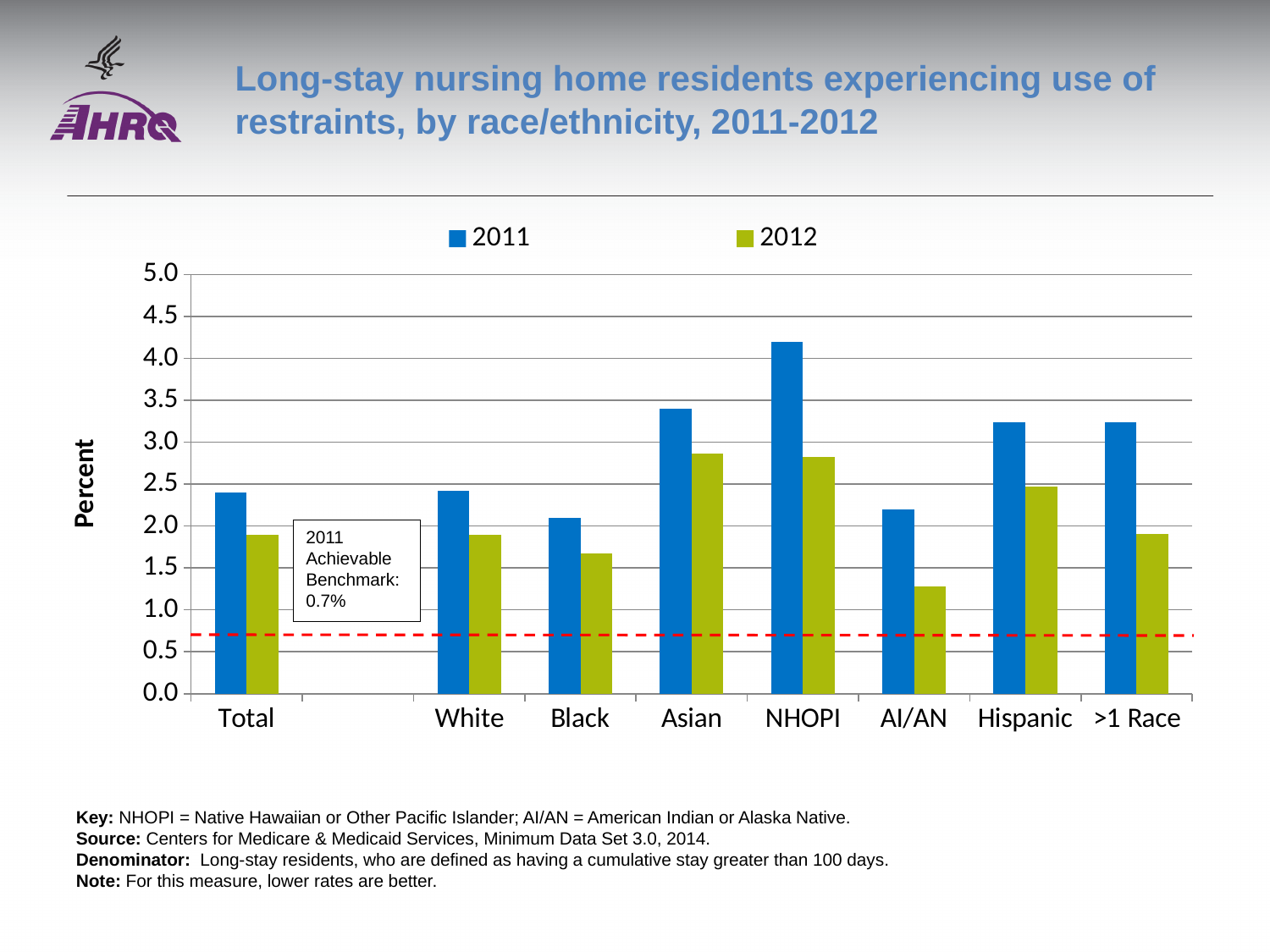
What kind of chart is shown on the slide? Bar chart How many series does the legend list? 2 Which category has the highest value for 2011? NHOPI Is the 2012 value for Black greater or less than 2.0? less Is the 2011 value for Asian greater or less than 3.0? greater Is the 2012 value for AI/AN greater or less than 1.5? less For the Hispanic category, which year has the larger value, 2011 or 2012? 2011 Which category has the lowest value for 2012? AI/AN Which is larger, the 2011 value for Asian or the 2011 value for Black? Asian How many race/ethnicity categories are shown on the x axis? 8 What is the 2011 achievable benchmark shown on the chart? 0.7%